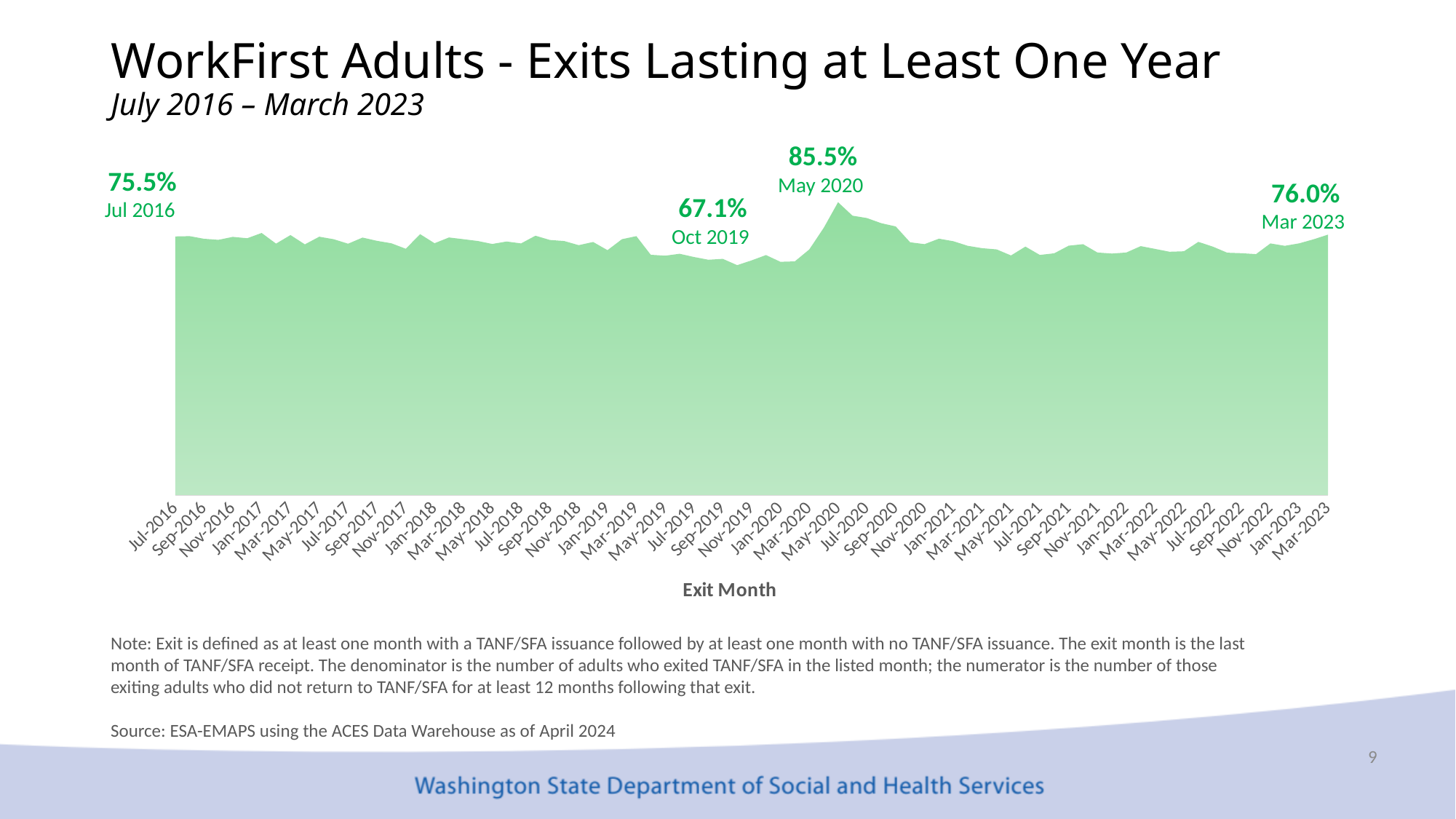
What is the title of the x axis? Exit Month Which of the labeled months has the lowest value? Oct 2019 Which is larger, the value for Jul 2016 or the value for Mar 2023? Mar 2023 What is the difference between the Mar 2023 value and the Jul 2016 value? 0.5 percentage points Which month has the highest value on the chart? May 2020 What is the value for Jul 2016? 75.5% What is the value for May 2020? 85.5% What is the difference between the May 2020 value and the Oct 2019 value? 18.4 percentage points What is the value for Mar 2023? 76.0% How many data points have printed value labels on the chart? 4 What is the value for Oct 2019? 67.1% What kind of chart is shown on the slide? Area chart